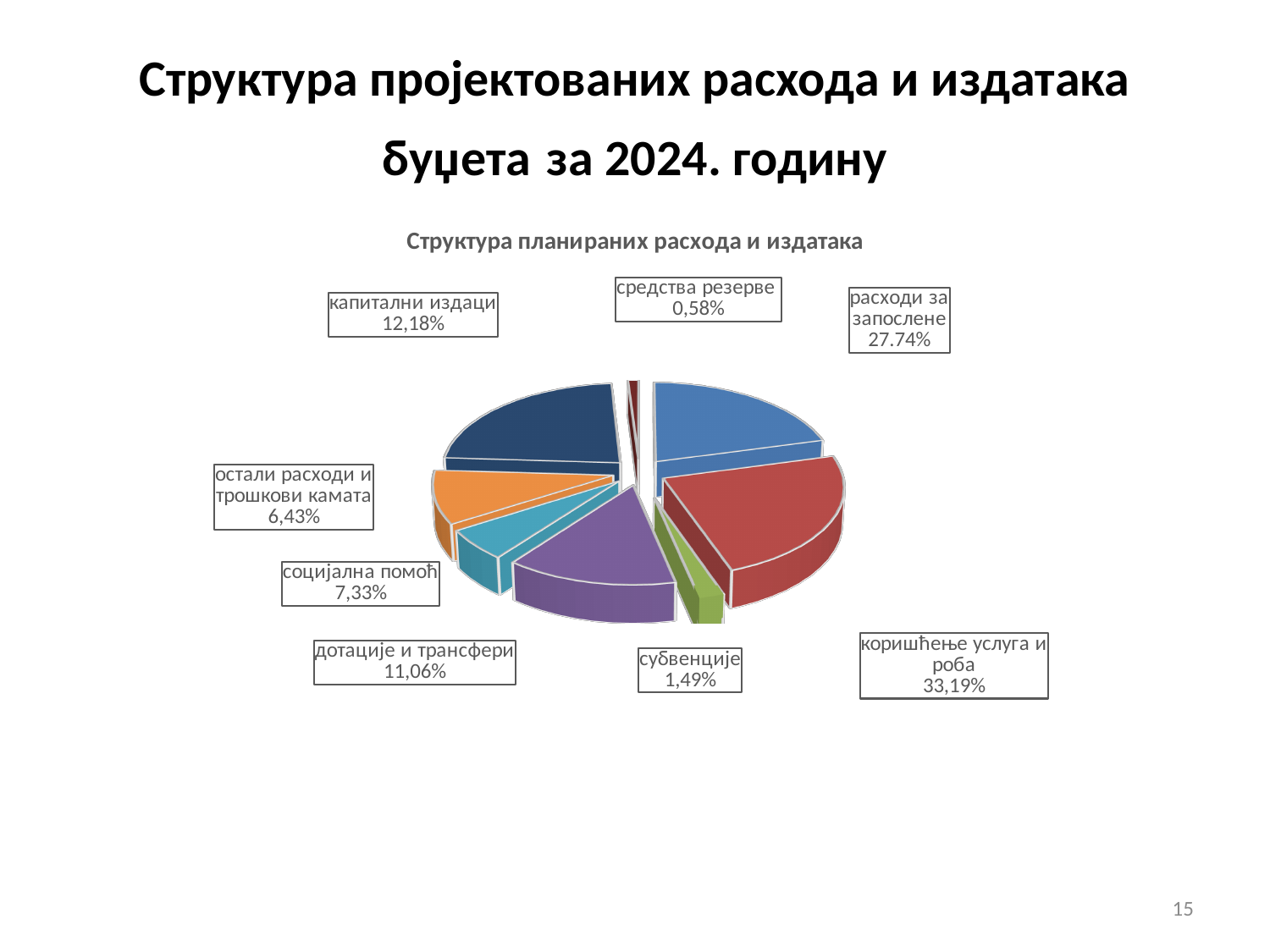
What share of the pie is коришћење услуга и роба? 33,19% What is the value shown for средства резерве? 0,58% Which category has the largest share of the pie? коришћење услуга и роба Which category has the smallest share of the pie? средства резерве What is the chart's title? Структура планираних расхода и издатака What is the value shown for капитални издаци? 12,18% What is the value shown for расходи за запослене? 27.74% What is the difference in percentage points between капитални издаци and дотације и трансфери? 1,12 What kind of chart is shown on the slide? pie chart How many slices does the pie chart have? 8 What is the value shown for дотације и трансфери? 11,06%